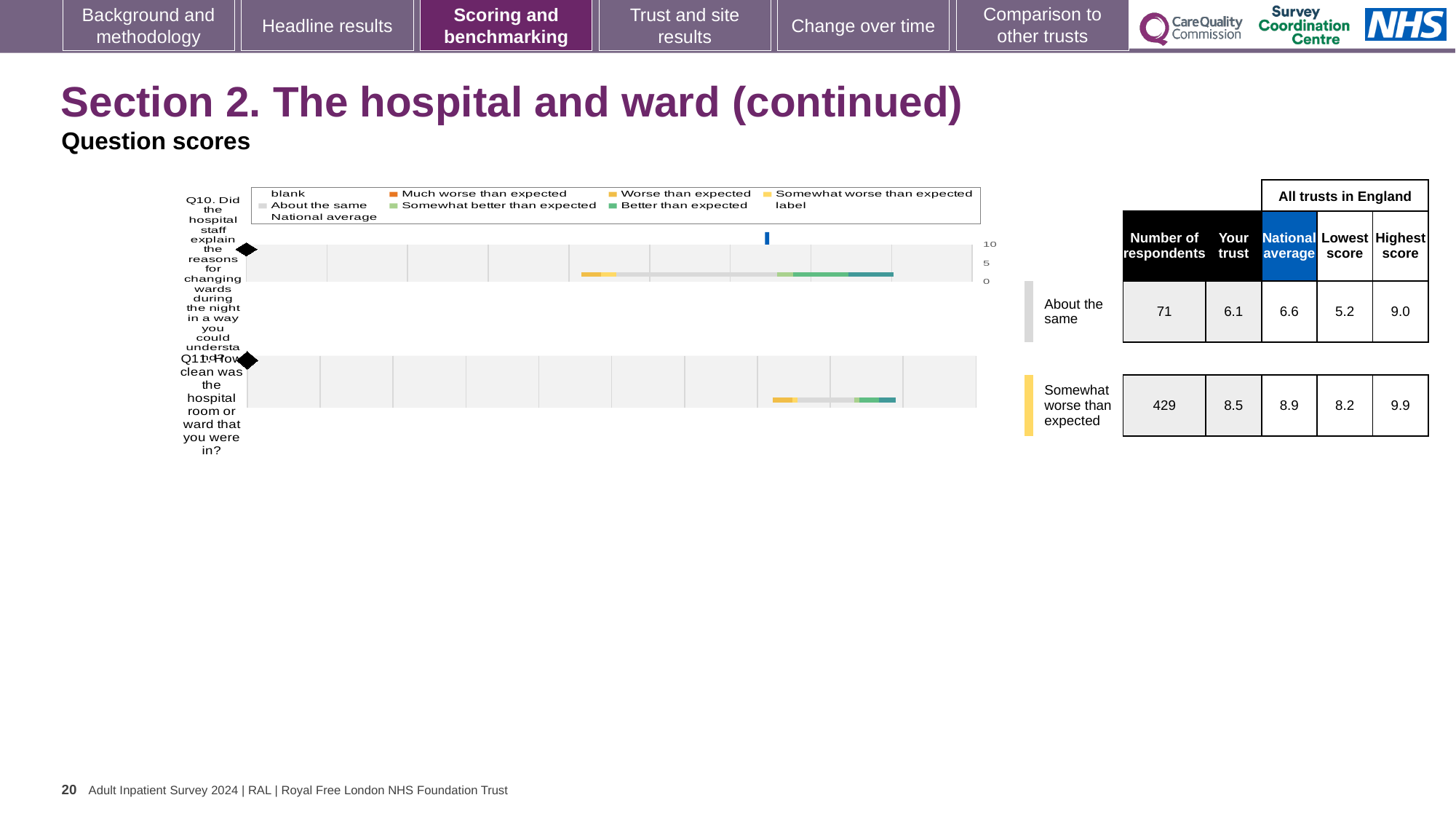
What is the highest score across all trusts in England for Q11? 9.9 Which question has the higher 'Your trust' score, Q10 or Q11? Q11 What is the national average score for Q10 shown in the table? 6.6 According to the table beside the chart, what is the 'Your trust' score for Q10 (explaining reasons for changing wards during the night)? 6.1 How many survey questions (categories) are plotted on the chart? 2 What kind of chart is shown on the slide? bar chart What benchmark category is Q11 assigned to on the slide? Somewhat worse than expected What is the national average score for Q11 shown in the table? 8.9 How many respondents answered Q11 according to the table? 429 Which two questions are plotted on the chart? Q10 and Q11 What is the difference between the national average and the 'Your trust' score for Q10? 0.5 According to the table beside the chart, what is the 'Your trust' score for Q11 (how clean was the hospital room or ward)? 8.5